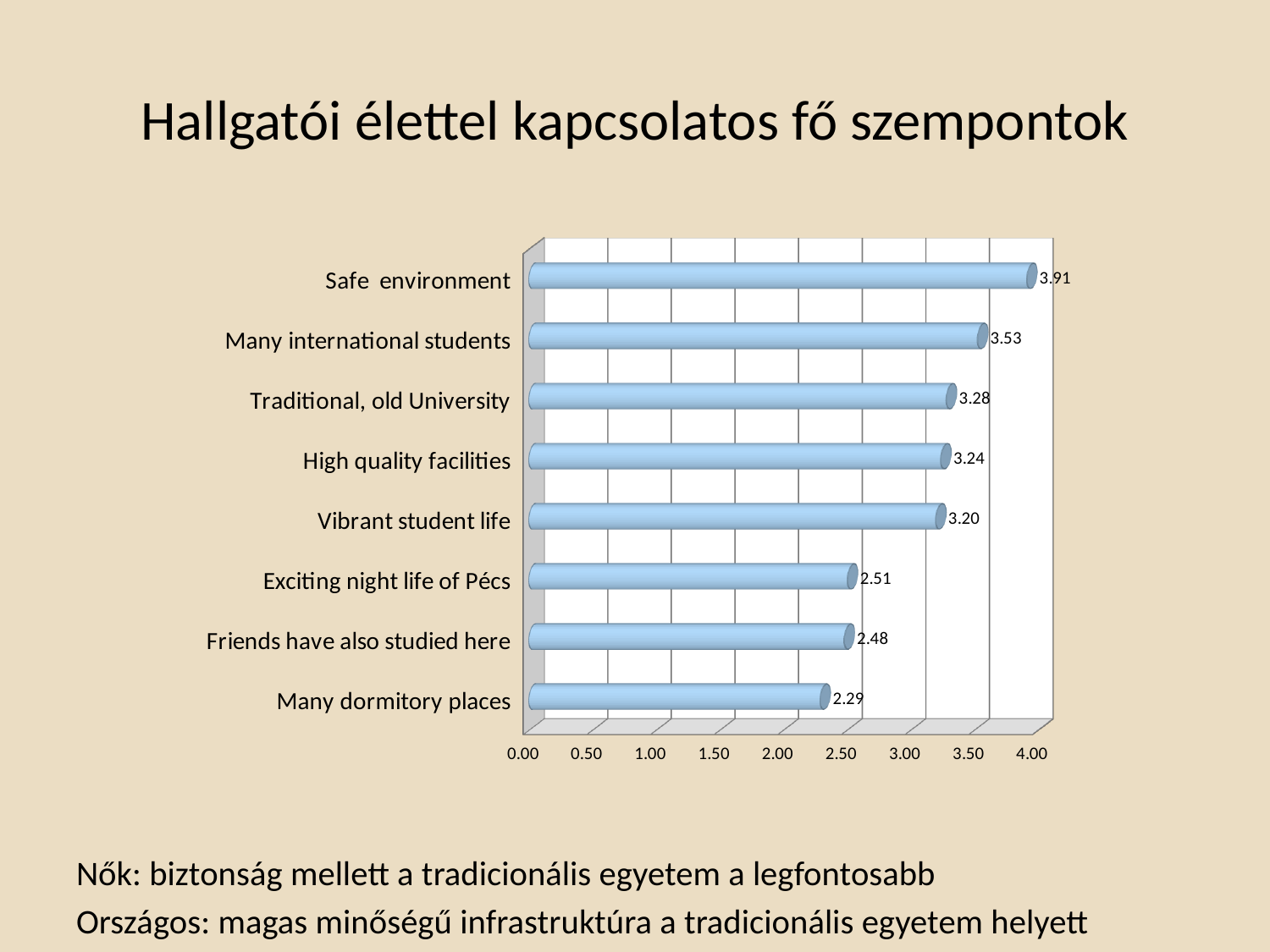
What is the difference between the values for Safe environment and Many international students? 0.38 Which is larger, the value for Traditional, old University or the value for Vibrant student life? Traditional, old University What is the value for Exciting night life of Pécs? 2.51 What is the value for Vibrant student life? 3.20 Is the value for Many international students greater or less than 3.00? greater Which category has the lowest value? Many dormitory places Which category has the highest value? Safe environment What is the value for Safe environment? 3.91 What kind of chart is shown on the slide? bar chart What is the value for Many dormitory places? 2.29 What is the difference between the values for Exciting night life of Pécs and Friends have also studied here? 0.03 How many categories are shown in the chart? 8